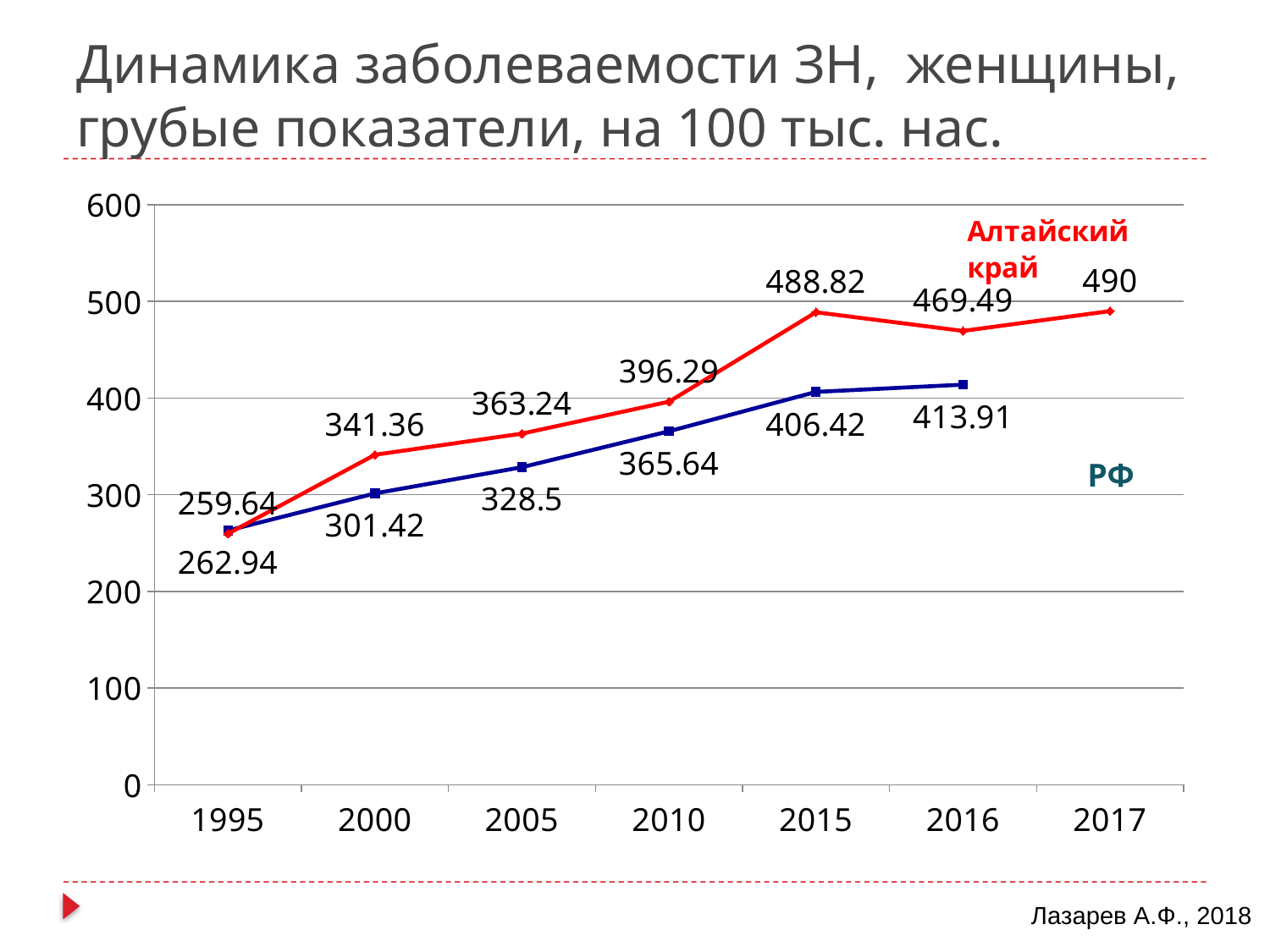
In which year is the value for РФ lowest? 1995 What is the value for Алтайский край in 2017? 490 How many series are plotted on the chart? 2 Does the value for РФ rise or fall from 1995 to 2016? rise What is the value for РФ in 2016? 413.91 In which year does Алтайский край reach its highest value? 2017 What type of chart is shown on the slide? line chart What is the difference between Алтайский край and РФ in 2015? 82.4 Which series has the higher value in 2010, Алтайский край or РФ? Алтайский край What is the value for Алтайский край in 2015? 488.82 What is the value for РФ in 2005? 328.5 How many years are shown on the x axis? 7